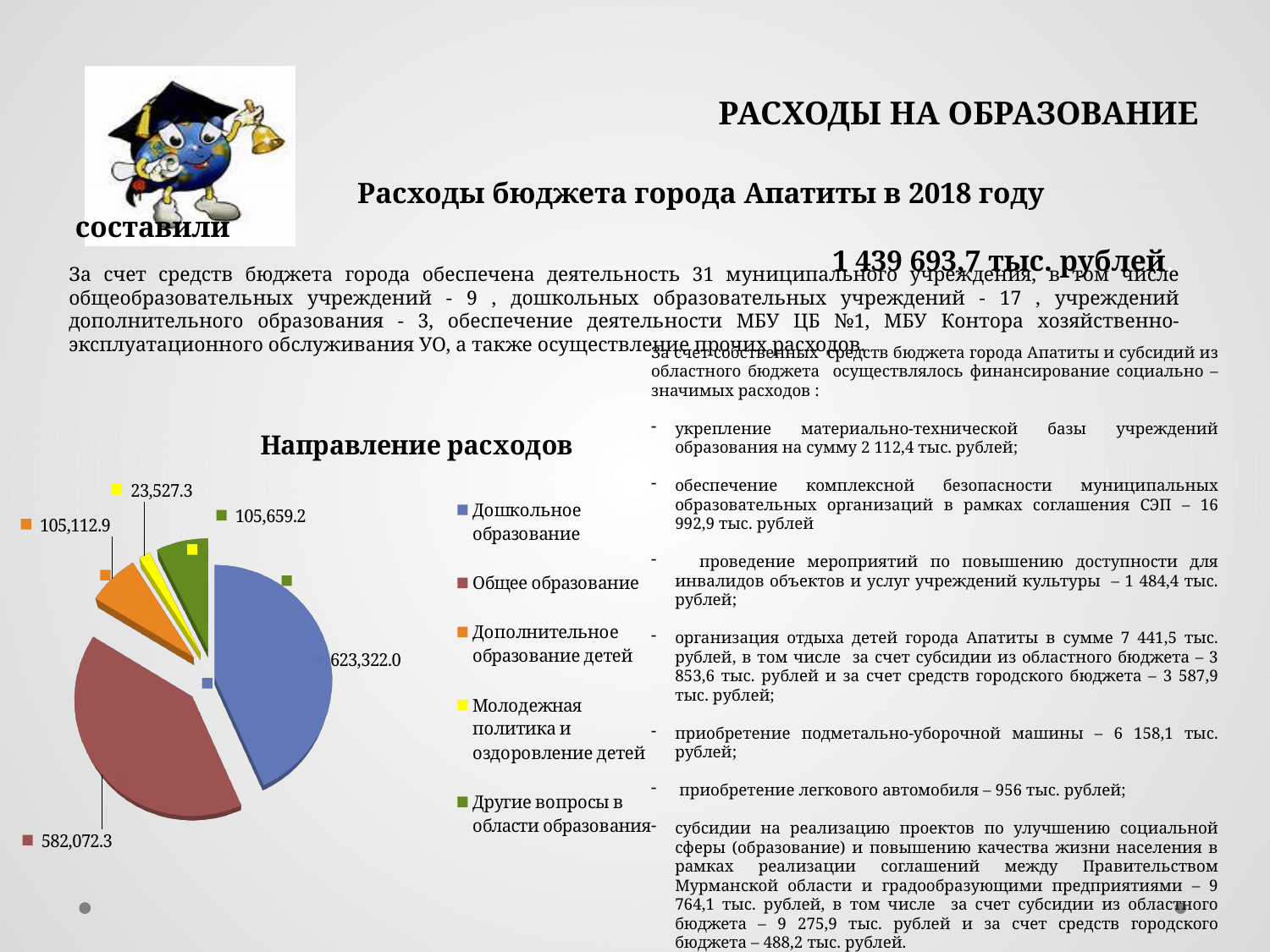
What colour is the slice for "Общее образование" in the pie chart? Red Which category has the smallest slice in the pie chart? Молодежная политика и оздоровление детей What is the value for "Общее образование" in the pie chart? 582,072.3 What is the value for "Другие вопросы в области образования" in the pie chart? 105,659.2 Which category has the largest slice in the pie chart? Дошкольное образование What is the value for "Дошкольное образование" in the pie chart? 623,322.0 What is the value for "Дополнительное образование детей" in the pie chart? 105,112.9 What is the value for "Молодежная политика и оздоровление детей" in the pie chart? 23,527.3 What type of chart is shown under the title "Направление расходов"? Pie chart What is the difference between the values for "Дошкольное образование" and "Общее образование" in the pie chart? 41,249.7 Which is larger in the pie chart: "Дополнительное образование детей" or "Другие вопросы в области образования"? Другие вопросы в области образования How many categories does the pie chart legend list? 5